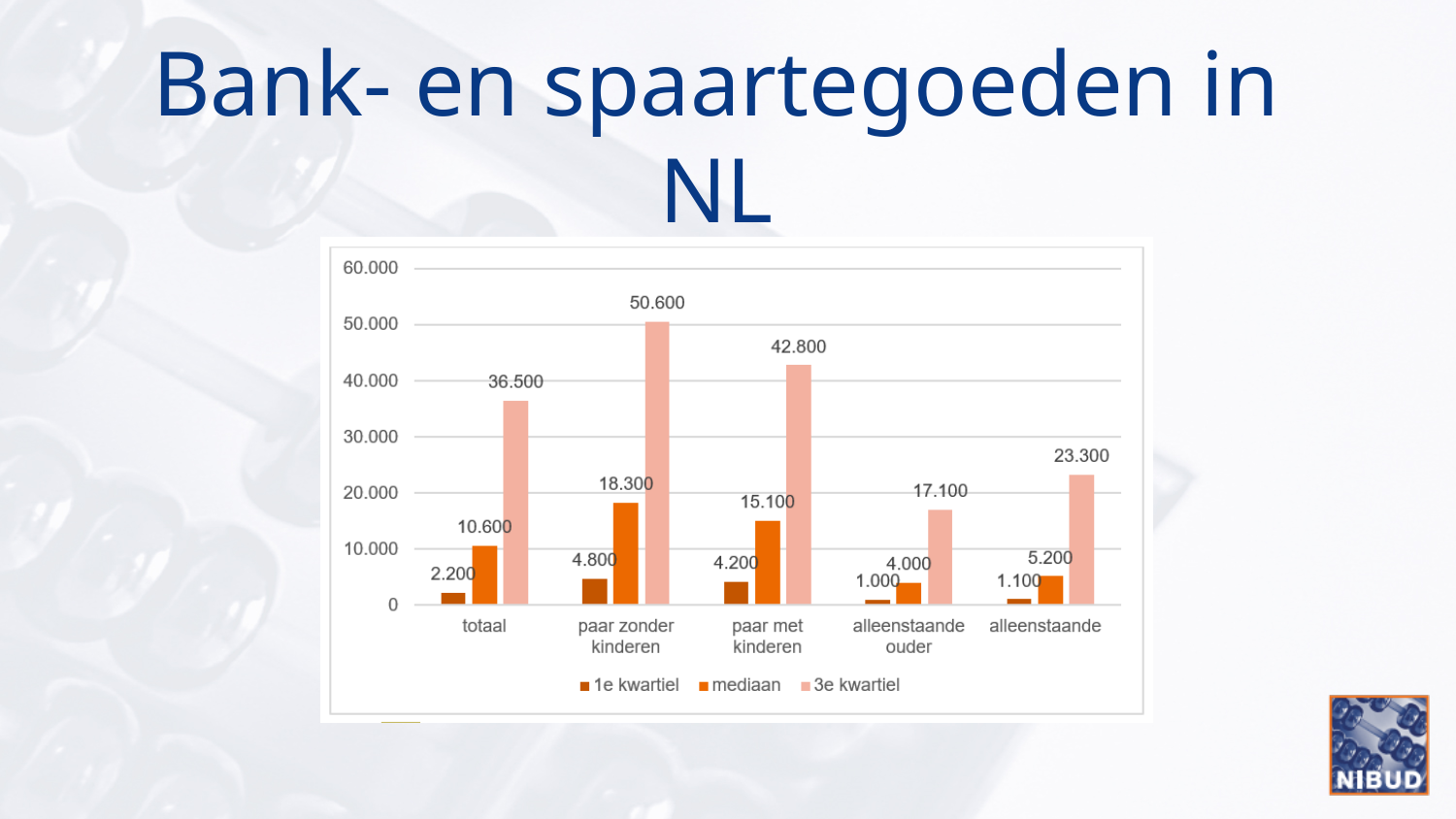
Which category has the lowest mediaan value? alleenstaande ouder How many categories are shown on the x axis? 5 What is the 1e kwartiel value for 'alleenstaande ouder'? 1.000 What is the difference between the 3e kwartiel values for 'paar zonder kinderen' and 'paar met kinderen'? 7.800 What is the mediaan value for 'totaal'? 10.600 Which category has the highest 3e kwartiel value? paar zonder kinderen What is the title of the slide containing the chart? Bank- en spaartegoeden in NL Is the 3e kwartiel value for 'totaal' greater or less than 30.000? greater How many series does the legend list? 3 What is the 3e kwartiel value for 'paar zonder kinderen'? 50.600 Which is larger: the mediaan for 'alleenstaande' or the mediaan for 'alleenstaande ouder'? alleenstaande What kind of chart is shown on the slide? bar chart